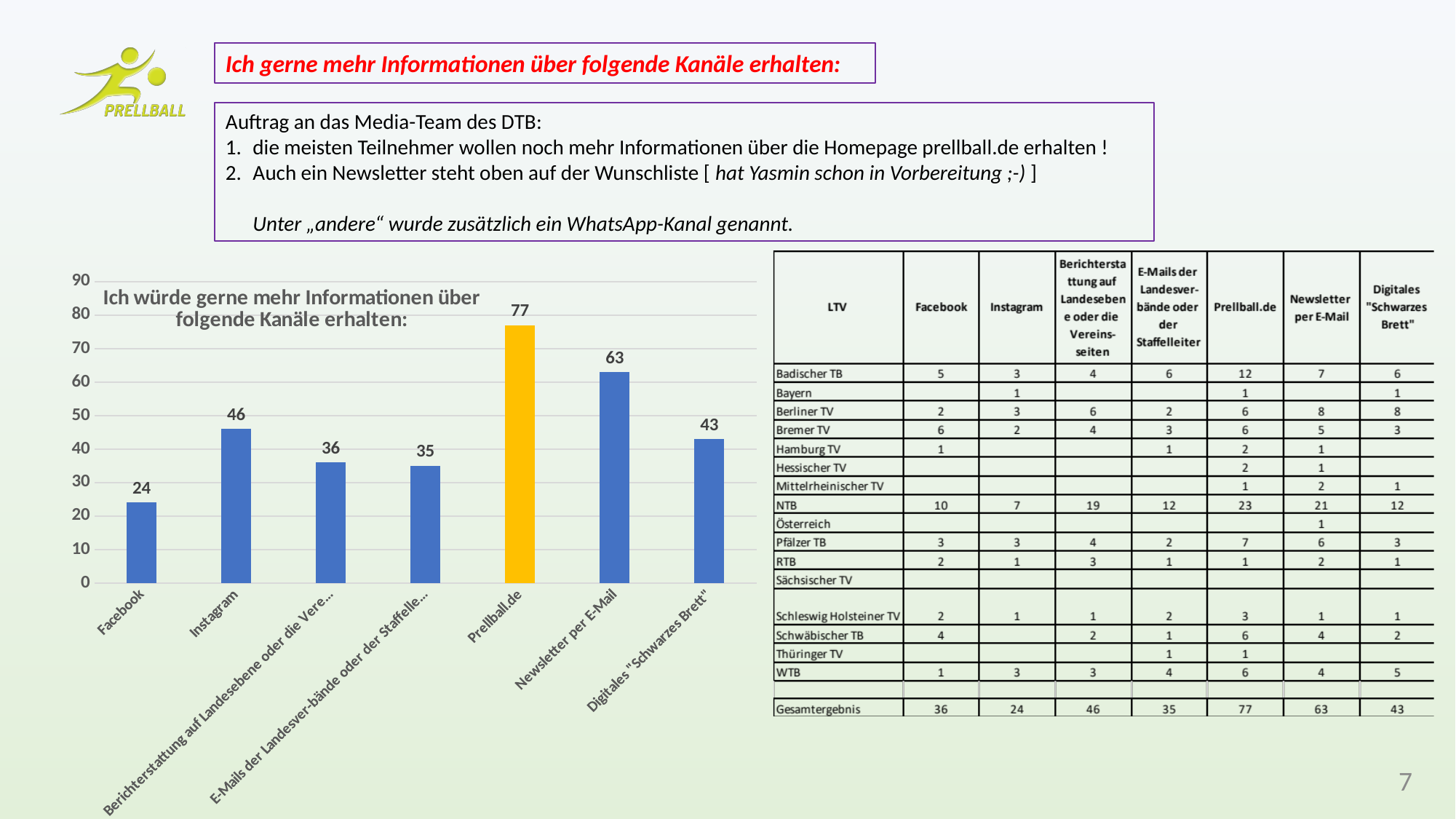
What value does the bar for Digitales "Schwarzes Brett" show? 43 What value does the bar for Prellball.de show? 77 What is the difference between the values for Instagram and Facebook? 22 Which bar in the chart is coloured differently (orange) from the others? Prellball.de What value does the bar for Newsletter per E-Mail show? 63 What type of chart is shown on the slide? Bar chart What value does the bar for Facebook show? 24 Which channel has the highest bar in the chart? Prellball.de Which channel has the lowest bar in the chart? Facebook Which is larger, the value for Instagram or the value for Digitales "Schwarzes Brett"? Instagram What is the difference between the values for Prellball.de and Newsletter per E-Mail? 14 How many channels (bars) are shown in the chart? 7